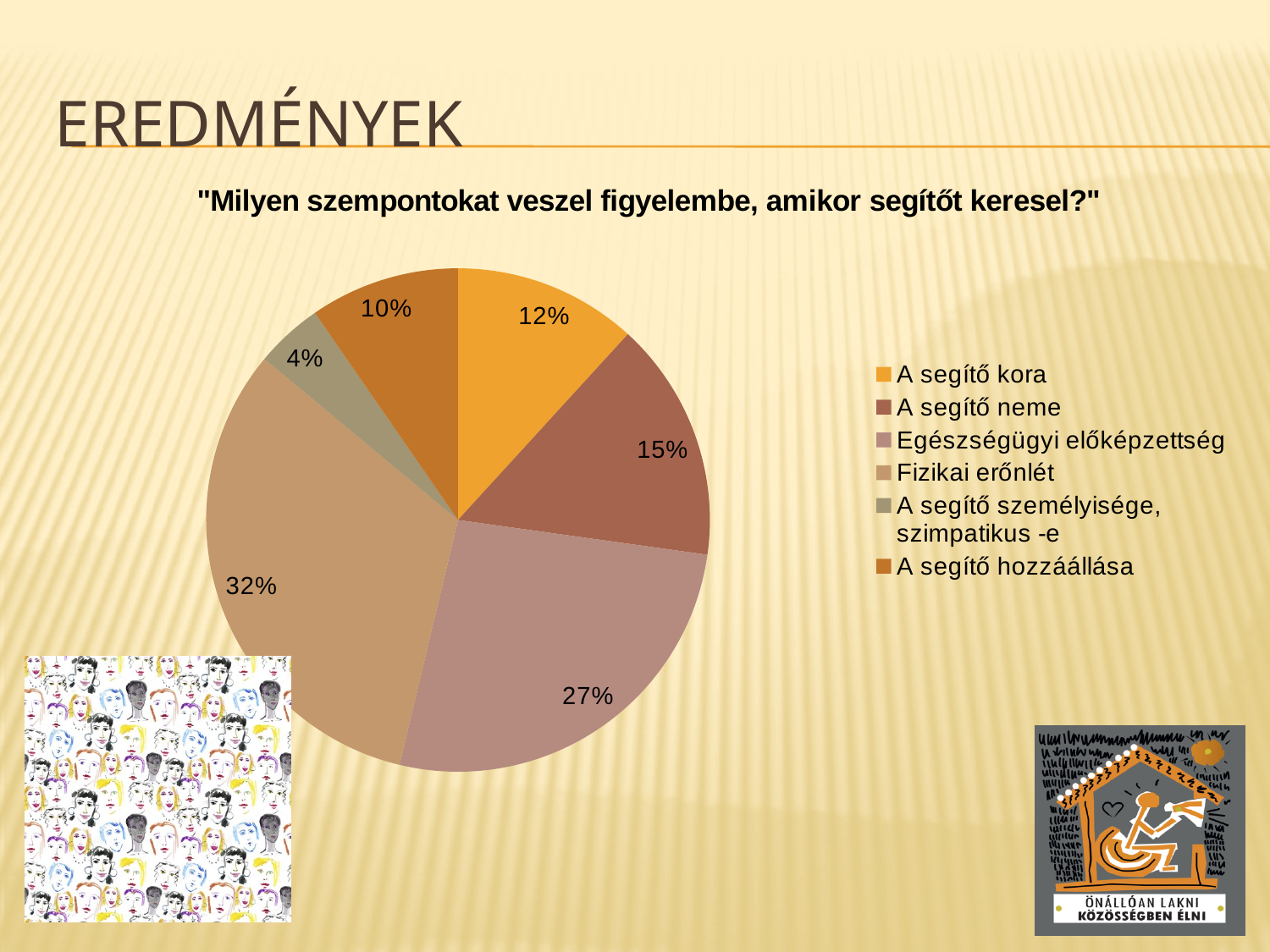
What share of the pie does "A segítő hozzáállása" have? 10% Which is larger, the slice for "A segítő neme" or the slice for "A segítő kora"? A segítő neme Which category has the largest slice of the pie? Fizikai erőnlét What share of the pie does "A segítő kora" have? 12% What is the title of the chart? "Milyen szempontokat veszel figyelembe, amikor segítőt keresel?" What share of the pie does "Fizikai erőnlét" have? 32% How many categories does the legend list? 6 What kind of chart is shown on the slide? pie chart What is the difference in percentage points between "Fizikai erőnlét" and "Egészségügyi előképzettség"? 5% Which category has the smallest slice of the pie? A segítő személyisége, szimpatikus -e